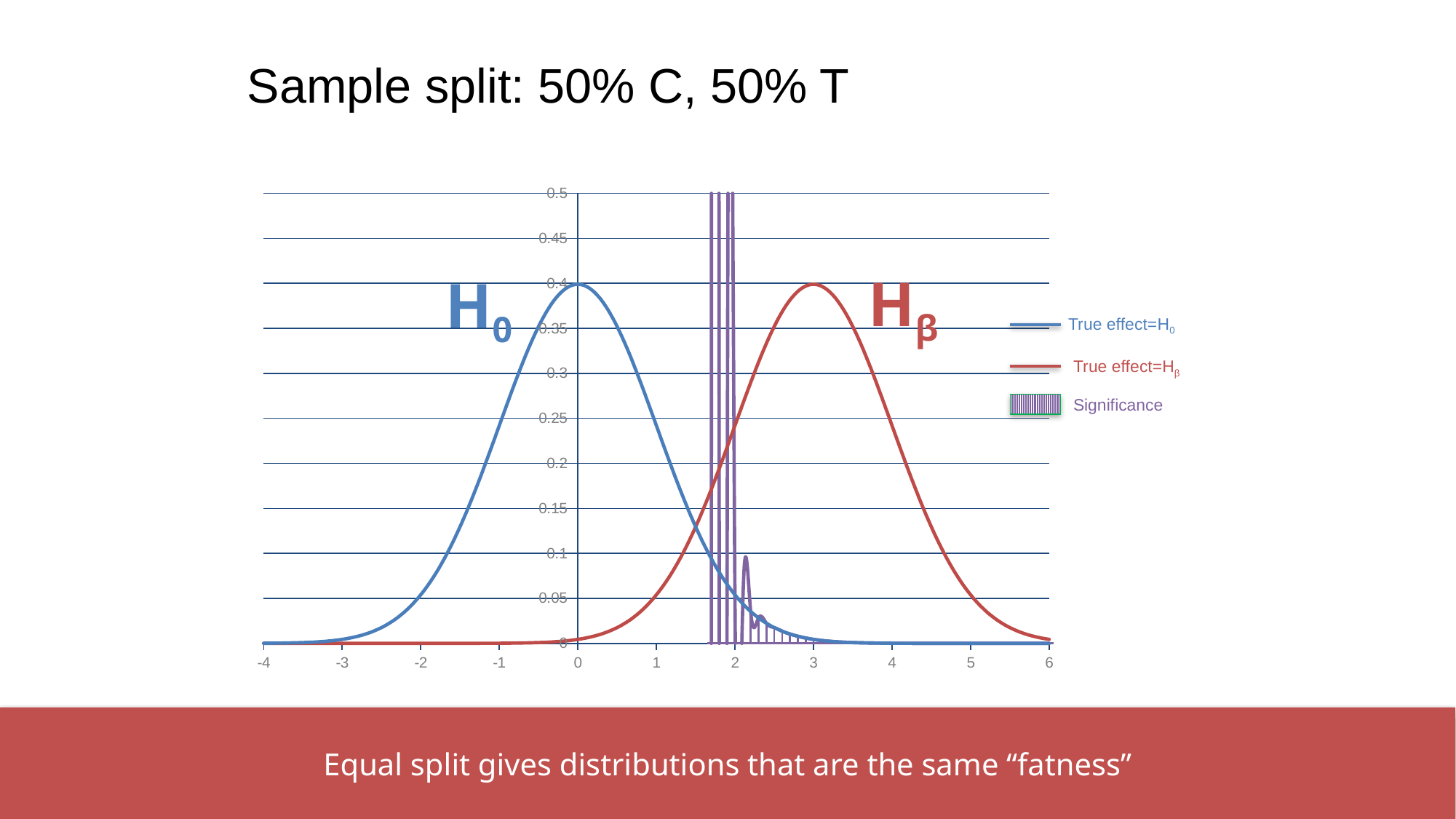
Which colour is used for the 'True effect=Hβ' series? red At x = 1, which curve has the higher value, 'True effect=H0' or 'True effect=Hβ'? True effect=H0 Is the value of the 'True effect=Hβ' curve at x = 3 greater or less than 0.35? greater Is the peak value of the 'True effect=H0' curve (at x = 0) greater or less than 0.3? greater At x = 2, which curve has the higher value, 'True effect=H0' or 'True effect=Hβ'? True effect=Hβ Does the 'True effect=H0' curve rise or fall as x increases from 0 to 6? fall How many series does the legend list? 3 Is the value of the 'True effect=Hβ' curve at x = 1 greater or less than 0.1? less Does the 'True effect=Hβ' curve rise or fall as x increases from -4 to 3? rise What kind of chart is shown on the slide? line chart What is the title of the slide containing the chart? Sample split: 50% C, 50% T